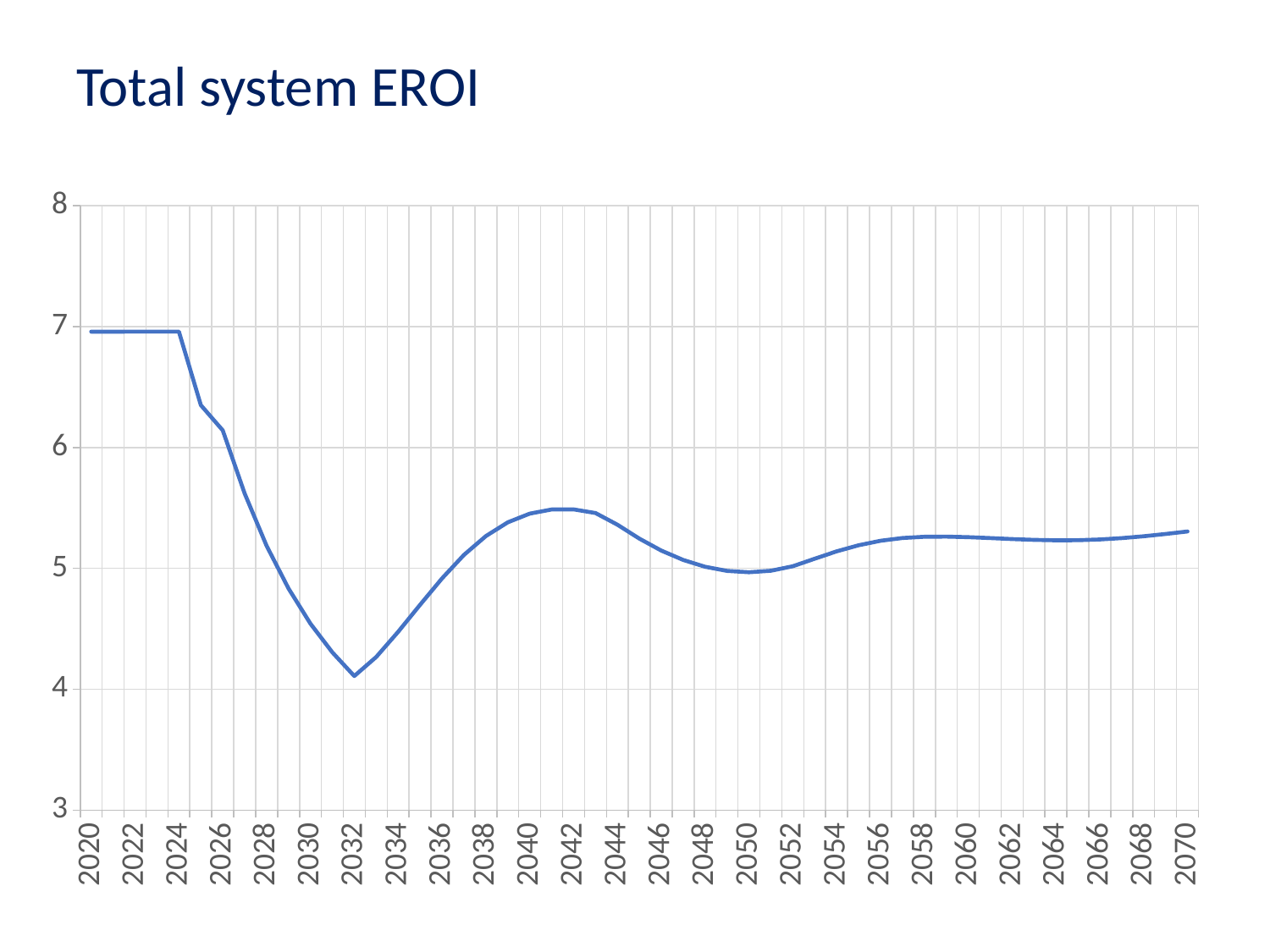
Which year has the larger value, 2032 or 2042? 2042 Is the value for 2020 greater or less than 6? greater Does the line rise or fall between 2024 and 2032? fall Is the value for 2036 greater or less than 6? less Is the value for 2070 greater or less than 6? less In which year does the line reach its lowest value? 2032 Does the line rise or fall between 2032 and 2042? rise What kind of chart is shown on the slide? line chart Which year has the larger value, 2020 or 2070? 2020 What is the title of the chart? Total system EROI